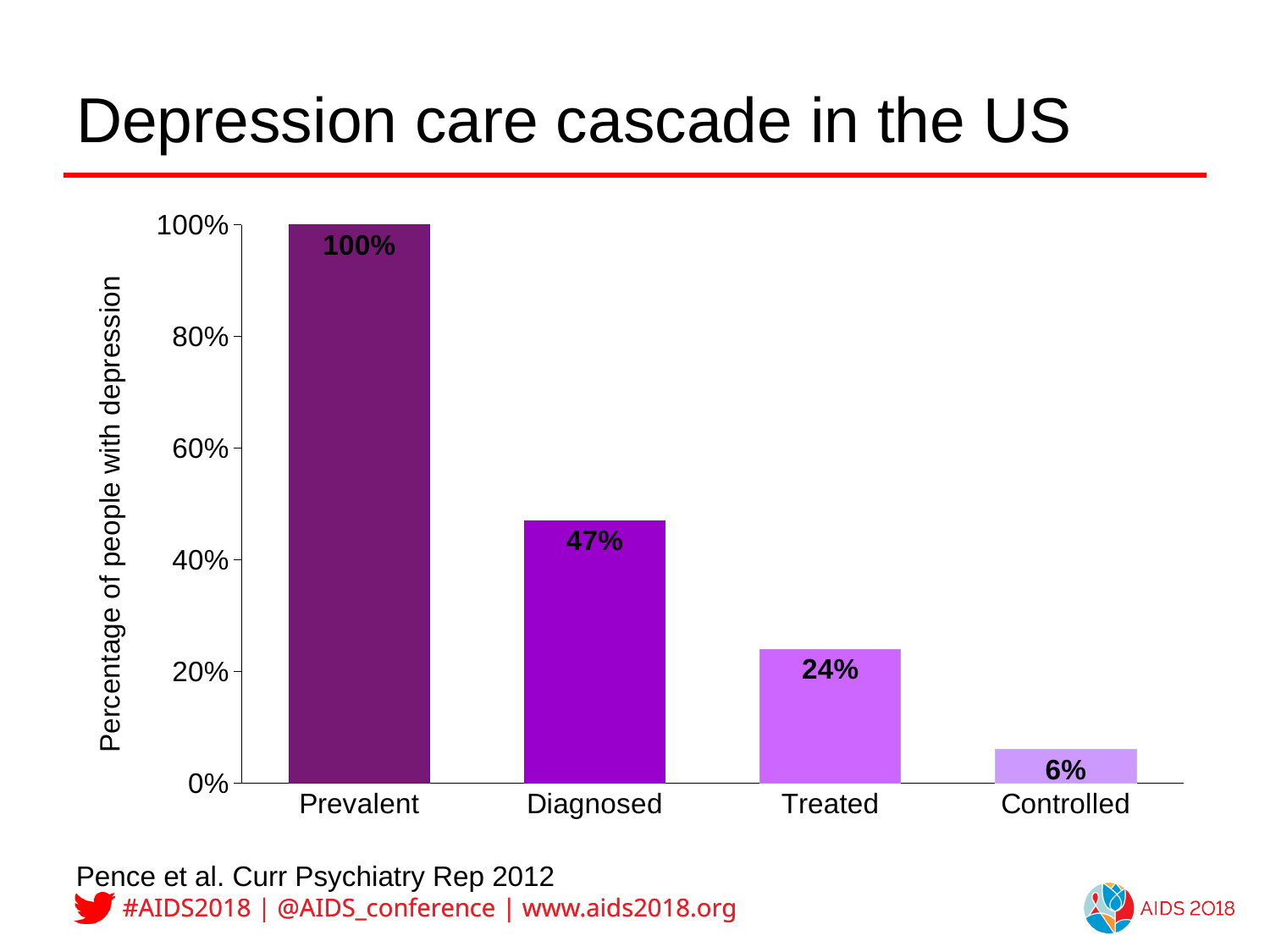
What kind of chart is shown on the slide? bar chart What is the difference between the values for Diagnosed and Treated? 23% What is the value for Controlled? 6% What is the difference between the values for Prevalent and Diagnosed? 53% What is the value for Treated? 24% Which is larger, the value for Treated or the value for Controlled? Treated Which category has the highest value? Prevalent Is the value for Diagnosed greater or less than 40%? greater Which category has the lowest value? Controlled How many categories are shown on the x axis? 4 Do the values rise or fall from Prevalent to Controlled along the x axis? fall What is the value for Diagnosed? 47%